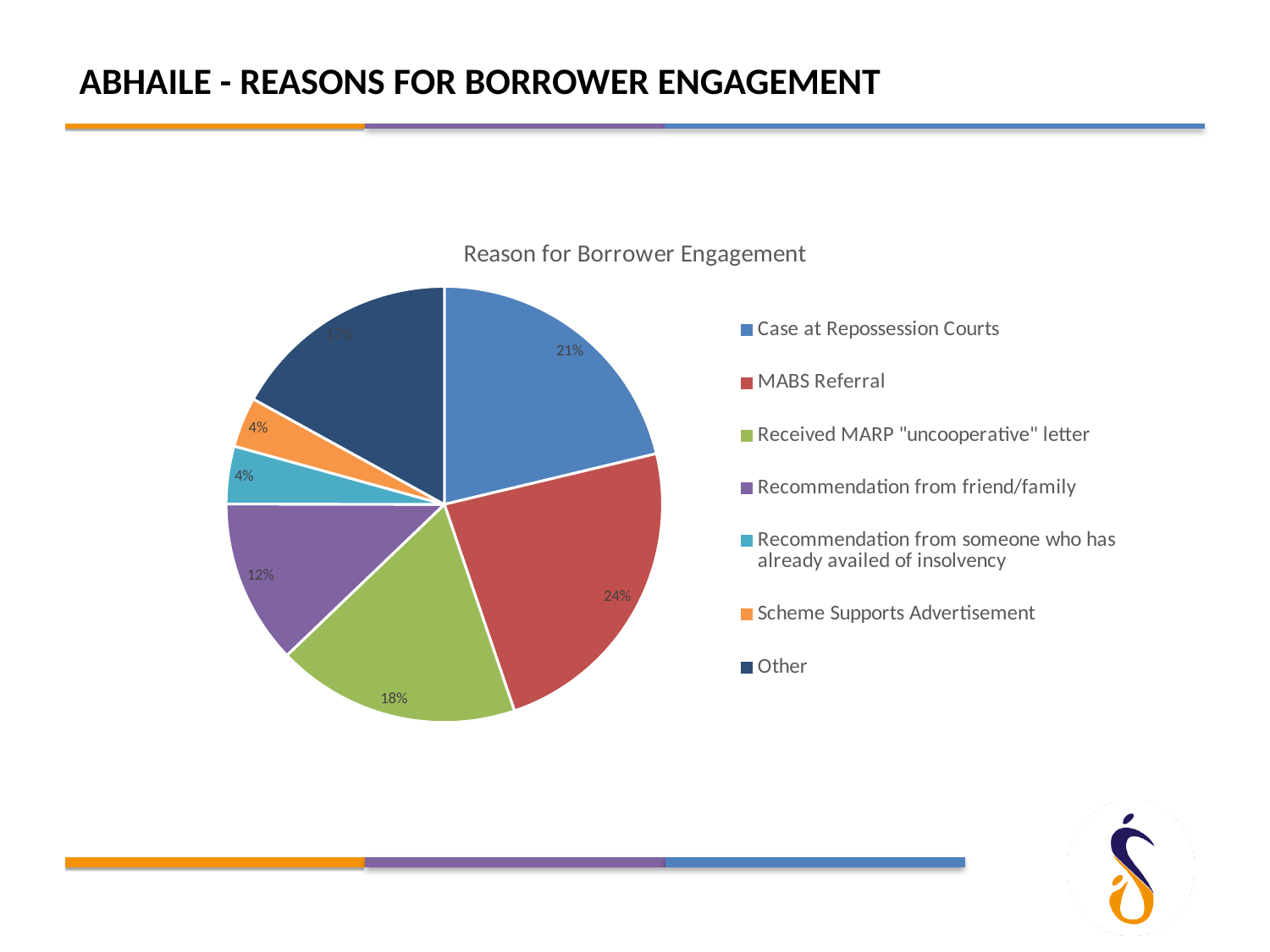
What colour is the slice for Scheme Supports Advertisement? Orange How many categories does the legend list? 7 What kind of chart is shown on the slide? Pie chart Which reason has the largest share of the pie? MABS Referral What share of the pie is Recommendation from friend/family? 12% Which is larger, the share for Recommendation from friend/family or the share for Other? Other What is the difference in percentage points between MABS Referral and Case at Repossession Courts? 3 percentage points What share of the pie is Scheme Supports Advertisement? 4% What is the chart's title? Reason for Borrower Engagement What share of the pie is Received MARP "uncooperative" letter? 18%